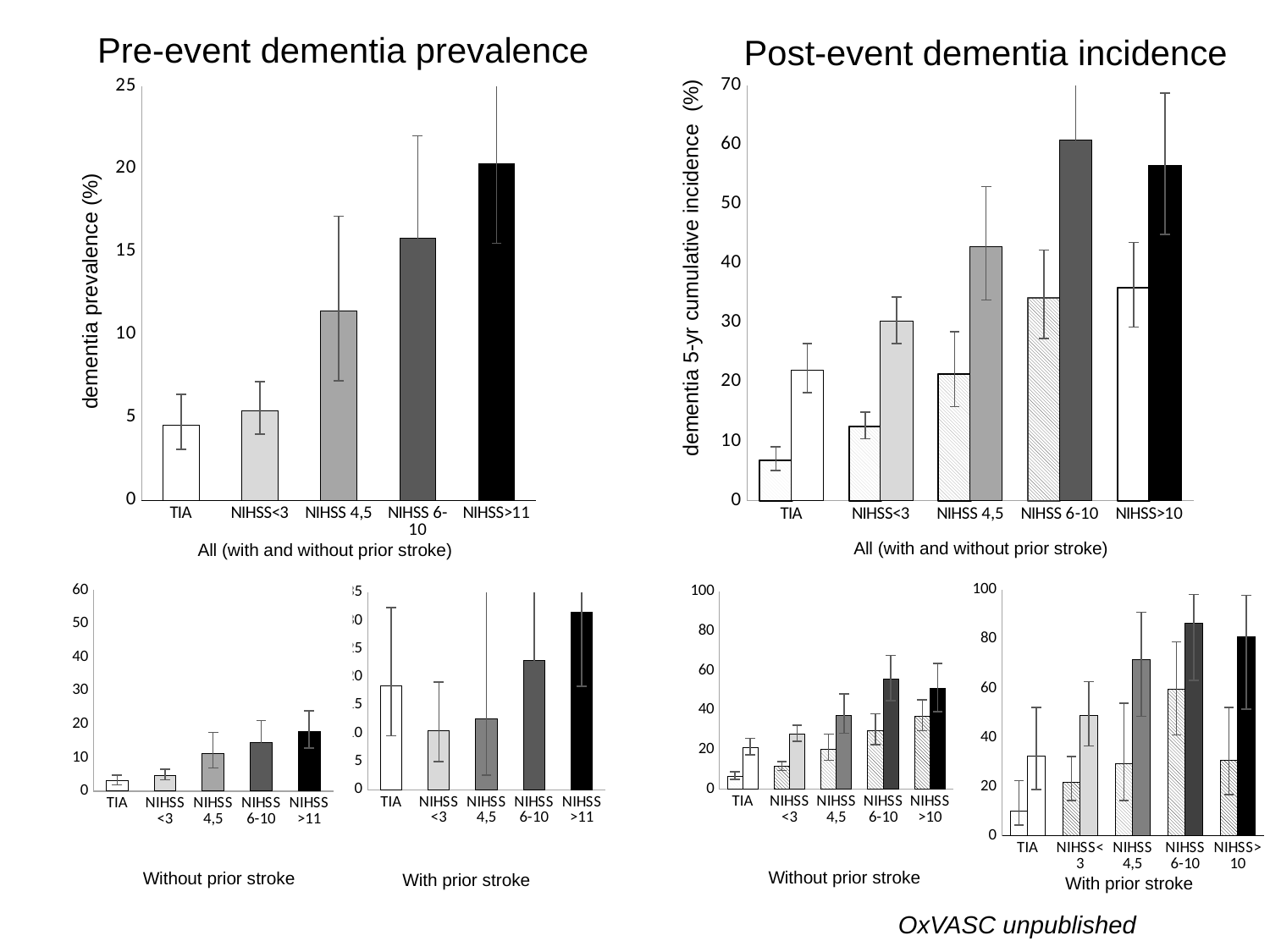
In the top-right 'Post-event dementia incidence' chart (All), is the hatched bar for NIHSS 6-10 greater or less than 30? greater What is the y-axis label of the top-right 'Post-event dementia incidence' chart? dementia 5-yr cumulative incidence (%) In the top-left 'Pre-event dementia prevalence' chart (All), which category has the lowest dementia prevalence? TIA In the top-right 'Post-event dementia incidence' chart (All), which category has the tallest solid bar? NIHSS 6-10 In the bottom-right 'With prior stroke' post-event chart, is the solid bar for NIHSS 4,5 greater or less than 60? greater In the top-left 'Pre-event dementia prevalence' chart (All), which category has the highest dementia prevalence? NIHSS>11 In the top-left 'Pre-event dementia prevalence' chart (All), is the value for NIHSS 4,5 greater or less than 10? greater What kind of chart is the 'Pre-event dementia prevalence' chart at the top left? bar chart In the top-left 'Pre-event dementia prevalence' chart (All), do the values rise or fall moving from TIA to NIHSS>11 along the x axis? rise In the top-left 'Pre-event dementia prevalence' chart (All), how many categories are shown on the x axis? 5 In the top-right 'Post-event dementia incidence' chart (All), is the solid bar for NIHSS 6-10 taller or shorter than the solid bar for NIHSS>10? taller